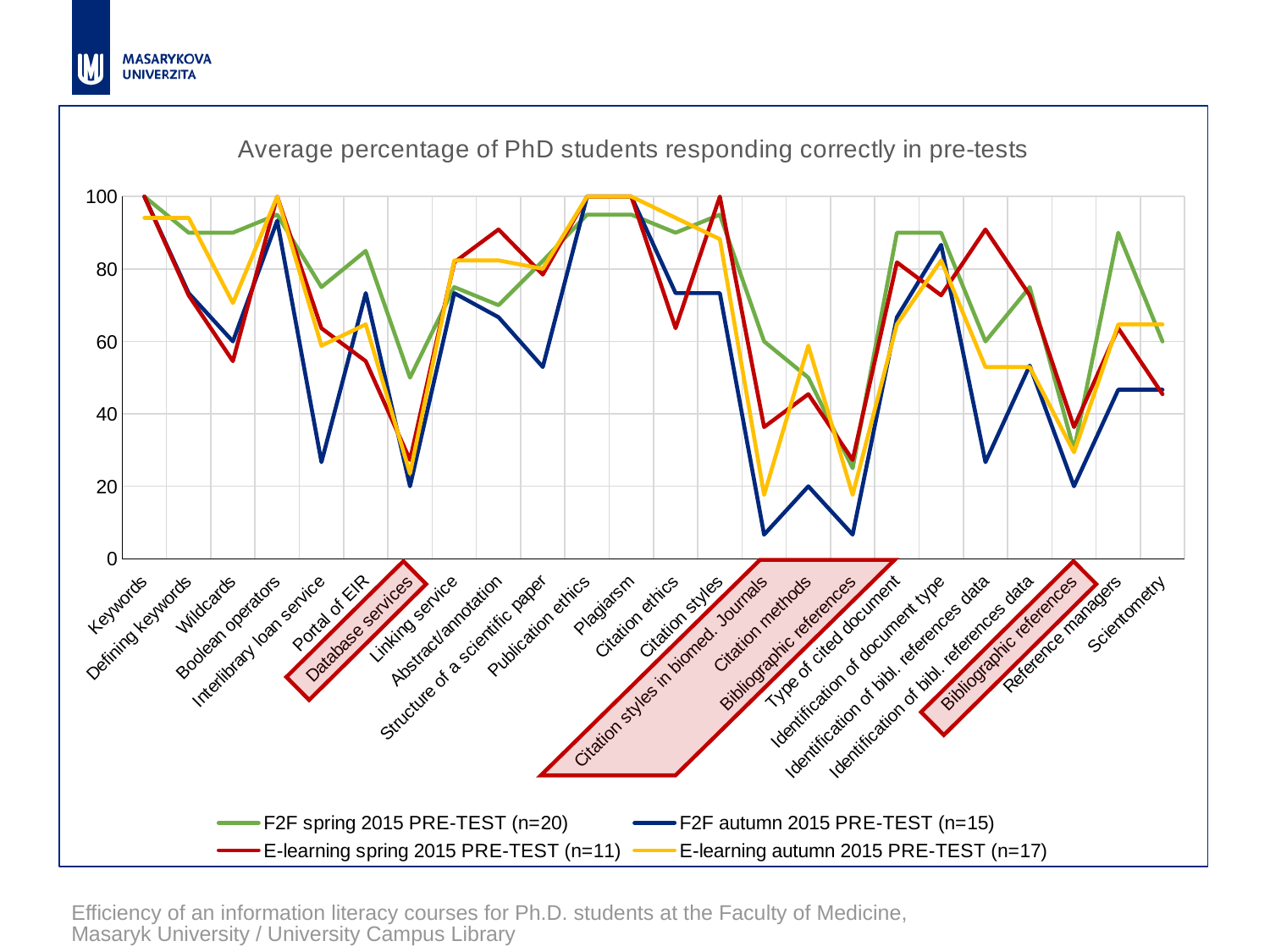
Is the value of F2F autumn 2015 PRE-TEST for Citation styles in biomed. Journals greater or less than 20? less What is the title of the chart? Average percentage of PhD students responding correctly in pre-tests Do the values of F2F autumn 2015 PRE-TEST rise or fall from Citation styles to Citation styles in biomed. Journals? fall For Wildcards, which is larger: F2F spring 2015 PRE-TEST or F2F autumn 2015 PRE-TEST? F2F spring 2015 PRE-TEST What kind of chart is shown on the slide? line chart Which series has the lowest value for Citation styles in biomed. Journals? F2F autumn 2015 PRE-TEST (n=15) How many categories are plotted along the x axis? 24 Which series has the highest value for Citation styles in biomed. Journals? F2F spring 2015 PRE-TEST (n=20) How many series does the legend list? 4 Which series is drawn in yellow? E-learning autumn 2015 PRE-TEST (n=17) Is the value of F2F autumn 2015 PRE-TEST for Interlibrary loan service greater or less than 40? less Is the value of F2F spring 2015 PRE-TEST for Reference managers greater or less than 80? greater